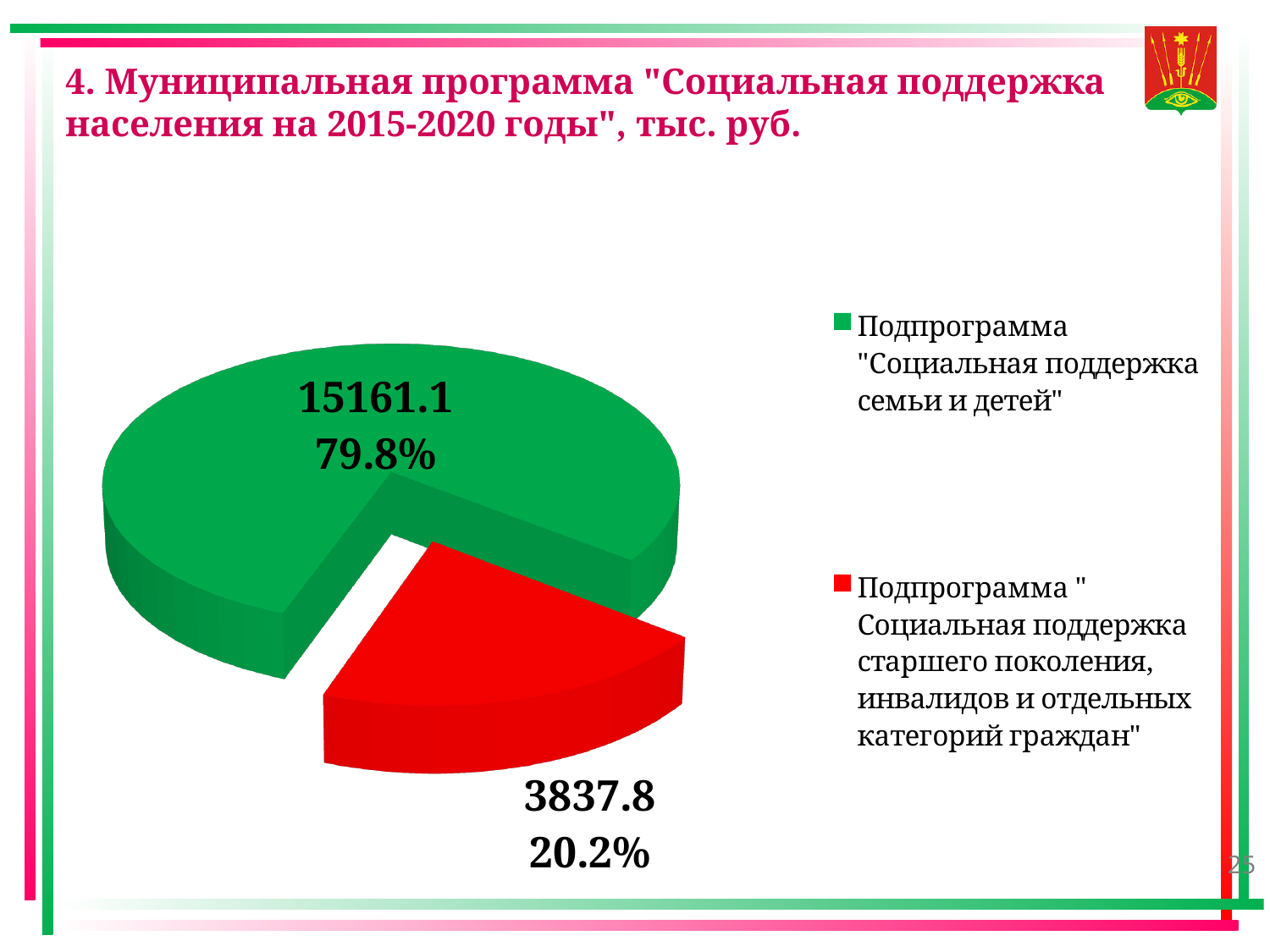
Which subprogram has the smallest slice of the pie? Подпрограмма "Социальная поддержка старшего поколения, инвалидов и отдельных категорий граждан" What is the value for Подпрограмма "Социальная поддержка семьи и детей"? 15161.1 What share of the pie does Подпрограмма "Социальная поддержка старшего поколения, инвалидов и отдельных категорий граждан" represent? 20.2% What is the value for Подпрограмма "Социальная поддержка старшего поколения, инвалидов и отдельных категорий граждан"? 3837.8 What type of chart is shown on the slide? Pie chart What share of the pie does Подпрограмма "Социальная поддержка семьи и детей" represent? 79.8% How many slices does the pie chart have? 2 What is the total of the two values shown in the pie chart? 18998.9 Which subprogram has the largest slice of the pie? Подпрограмма "Социальная поддержка семьи и детей" What colour is the slice for Подпрограмма "Социальная поддержка семьи и детей"? Green Which is larger: the value for Подпрограмма "Социальная поддержка семьи и детей" or the value for Подпрограмма "Социальная поддержка старшего поколения, инвалидов и отдельных категорий граждан"? Подпрограмма "Социальная поддержка семьи и детей" What is the difference between the values for Подпрограмма "Социальная поддержка семьи и детей" and Подпрограмма "Социальная поддержка старшего поколения, инвалидов и отдельных категорий граждан"? 11323.3